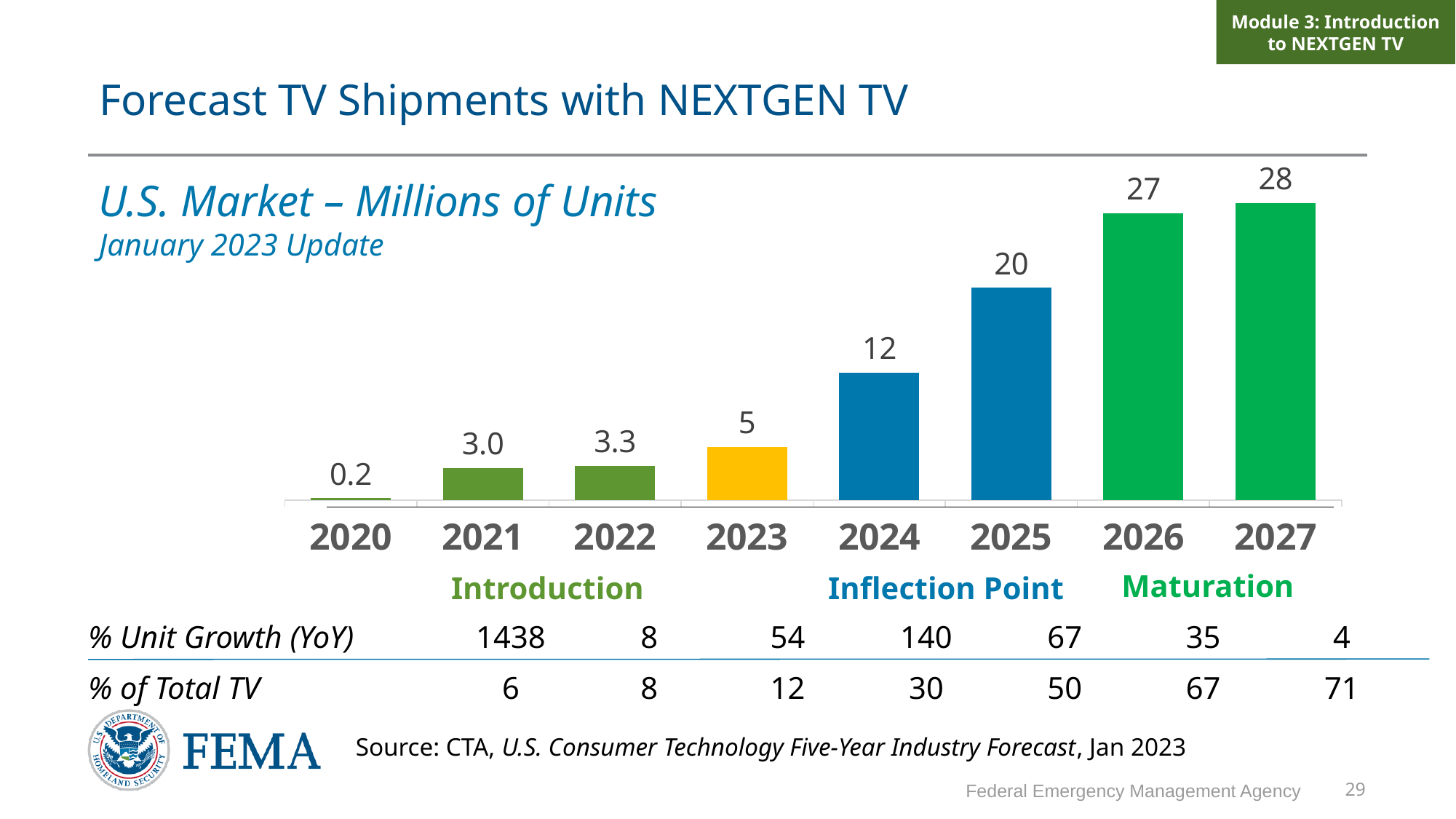
What is the chart's subtitle describing the market and units? U.S. Market – Millions of Units What is the difference between the values for 2027 and 2025? 8 Do the values rise or fall from 2020 to 2027? rise What is the difference between the values for 2022 and 2021? 0.3 How many years are shown on the x axis? 8 Which is larger, the value for 2023 or the value for 2024? 2024 What is the value shown for 2020? 0.2 Which year has the highest value? 2027 Which year has the lowest value? 2020 What is the value shown for 2022? 3.3 What is the forecast value for 2024? 12 What kind of chart is this? bar chart